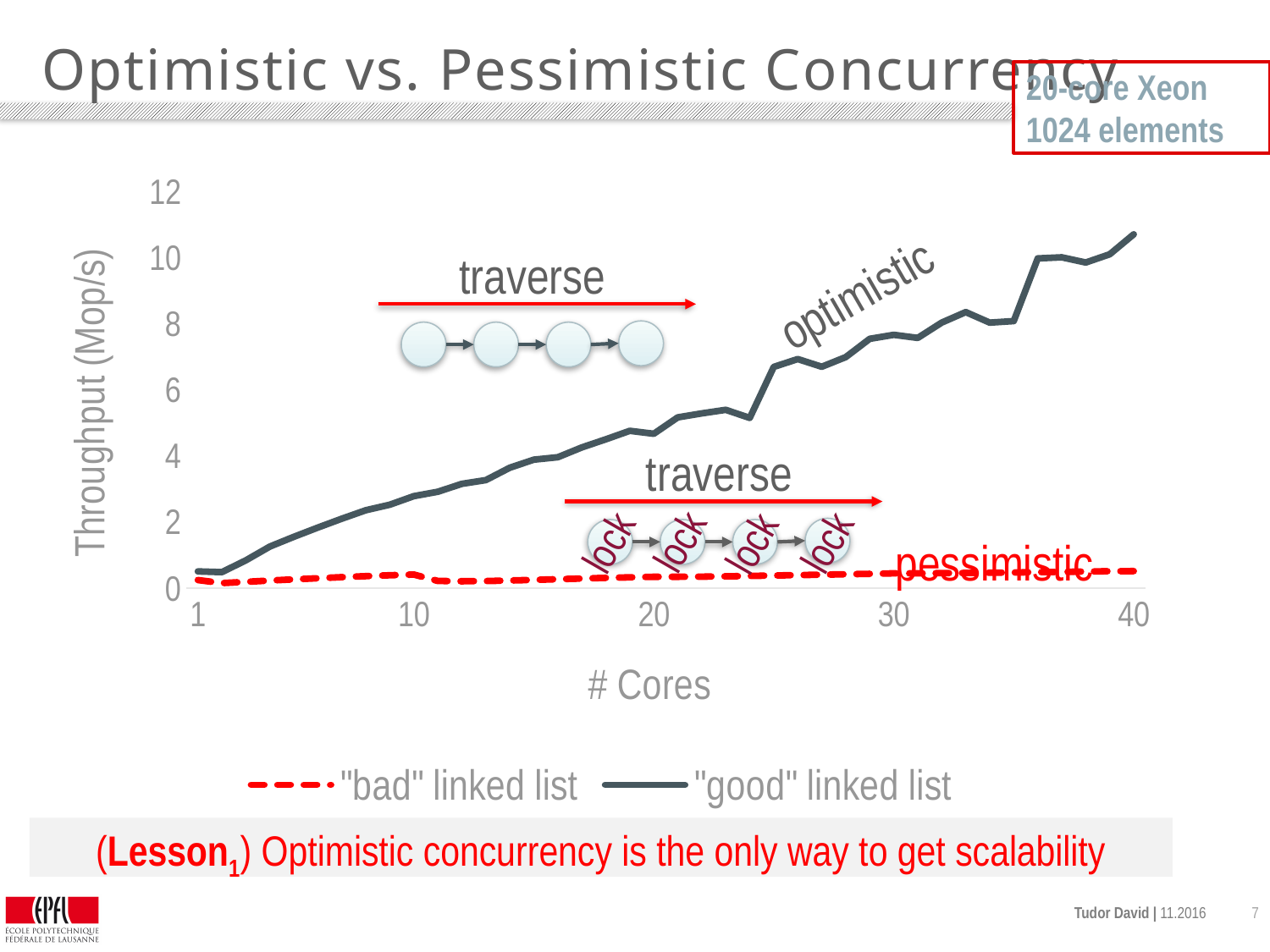
Is the throughput of the "good" linked list at 40 cores greater or less than 10 Mop/s? greater Which series has the higher throughput at 30 cores, the "bad" linked list or the "good" linked list? "good" linked list What kind of chart is shown on the slide? line chart Is the throughput of the "good" linked list at 20 cores greater or less than 4 Mop/s? greater Is the throughput of the "bad" linked list at 40 cores greater or less than 2 Mop/s? less Which series is drawn with a dashed red line? "bad" linked list What is the label of the x axis? # Cores What is the label of the y axis? Throughput (Mop/s) How many series does the chart legend list? 2 Does the throughput of the "good" linked list rise or fall as the number of cores increases? rise